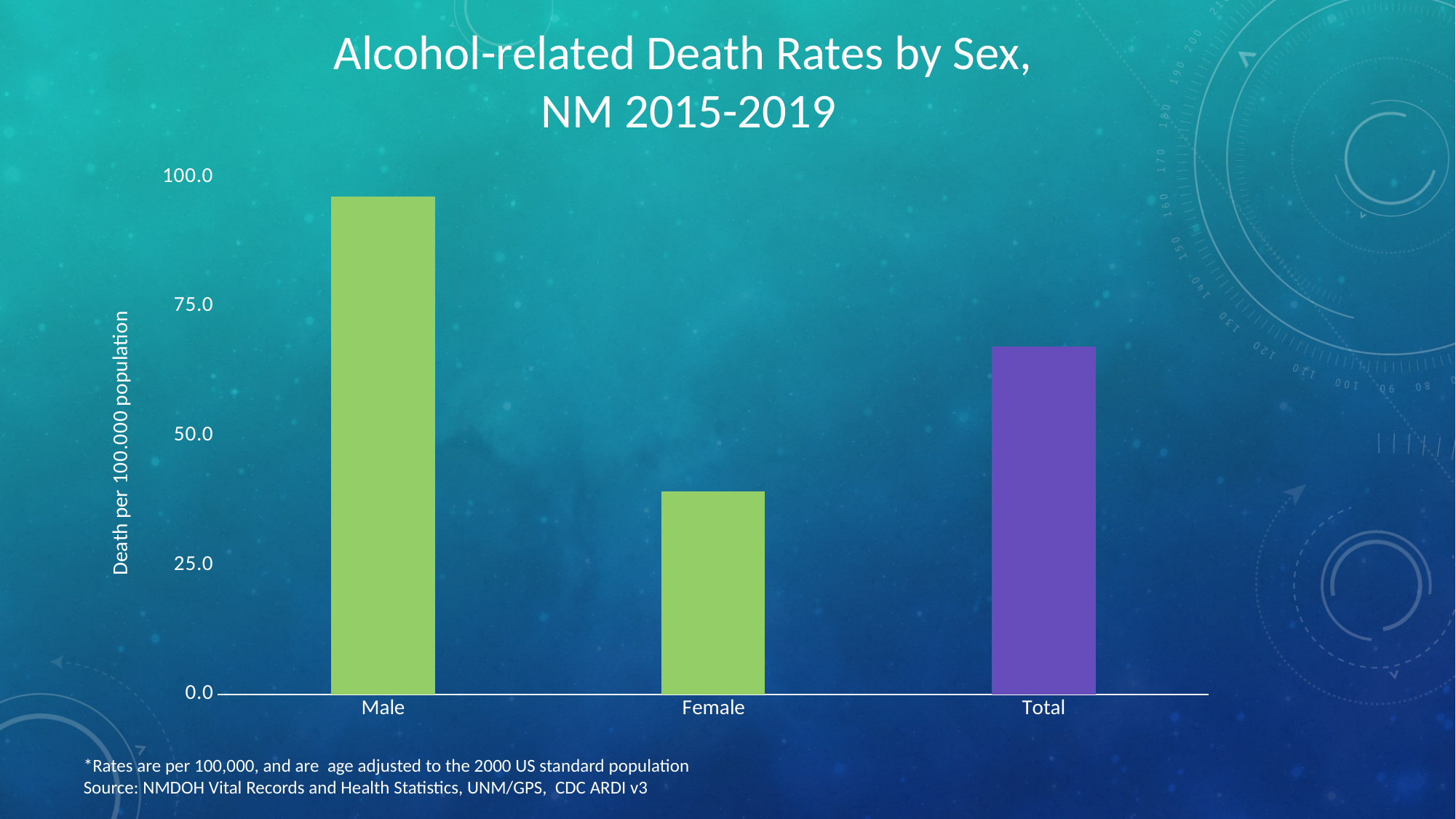
Is the death rate for Total greater or less than 50.0? greater Which category has the lowest alcohol-related death rate? Female Which is larger, the death rate for Total or for Female? Total Is the death rate for Female greater or less than 25.0? greater Is the death rate for Male greater or less than 75.0? greater Which category has the highest alcohol-related death rate? Male What is the title of the chart? Alcohol-related Death Rates by Sex, NM 2015-2019 What kind of chart is shown on the slide? bar chart How many categories are shown on the x axis of the chart? 3 Which is larger, the death rate for Male or for Female? Male